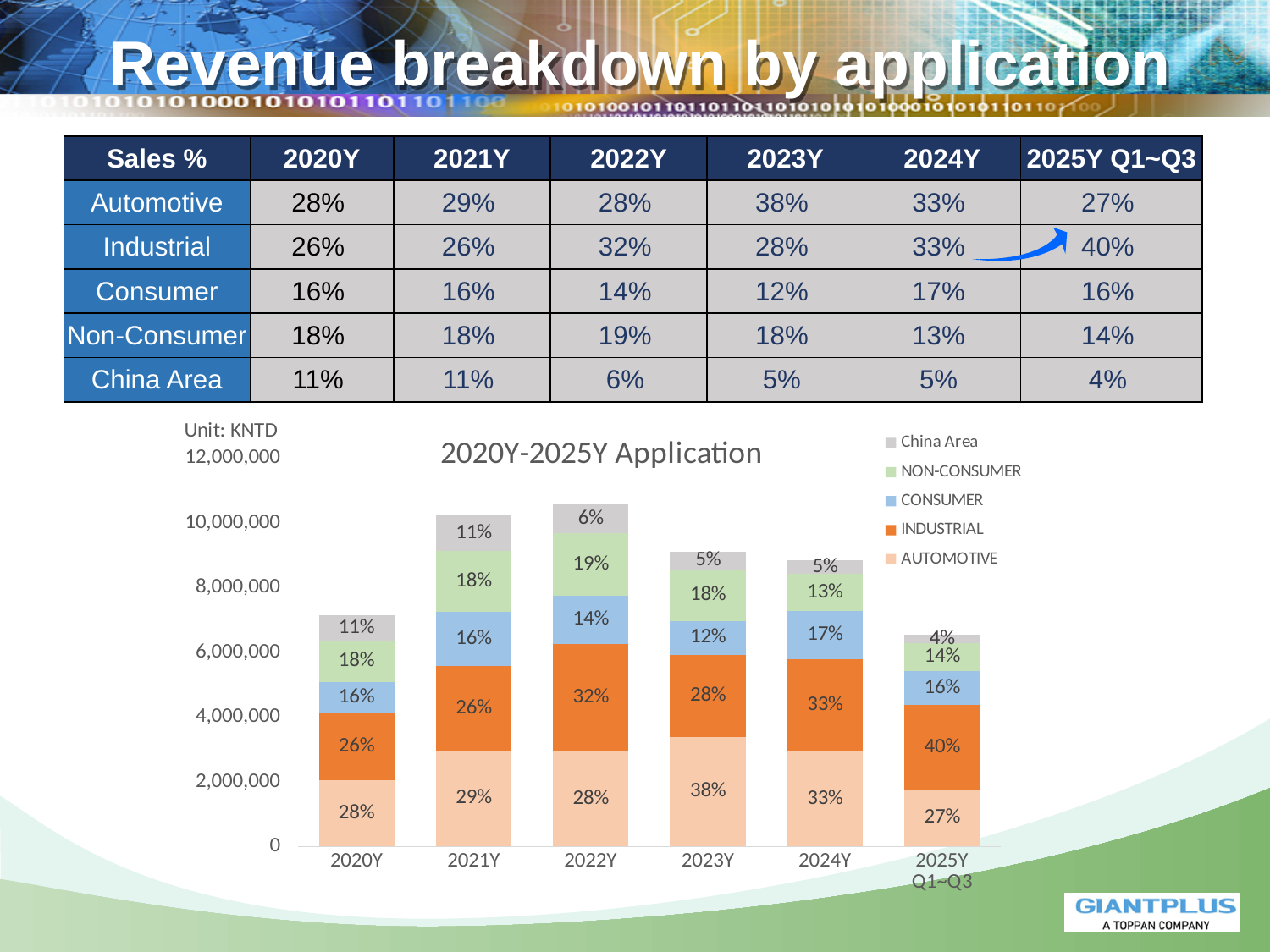
Is the total height of the 2021Y bar greater or less than 10,000,000? greater What type of chart is shown on the slide? Stacked bar chart How many bars (periods) are plotted on the x axis of the chart? 6 What is the AUTOMOTIVE share labelled on the 2023Y bar? 38% By how many percentage points does the INDUSTRIAL share in 2025Y Q1~Q3 exceed the INDUSTRIAL share in 2020Y? 14 percentage points What is the China Area share labelled on the 2021Y bar? 11% Which period has the tallest stacked bar in the chart? 2022Y Is the total height of the 2020Y bar greater or less than 8,000,000? less Which period has the shortest stacked bar in the chart? 2025Y Q1~Q3 What is the INDUSTRIAL share labelled on the 2025Y Q1~Q3 bar? 40% How many series does the chart legend list? 5 What is the NON-CONSUMER share labelled on the 2024Y bar? 13%